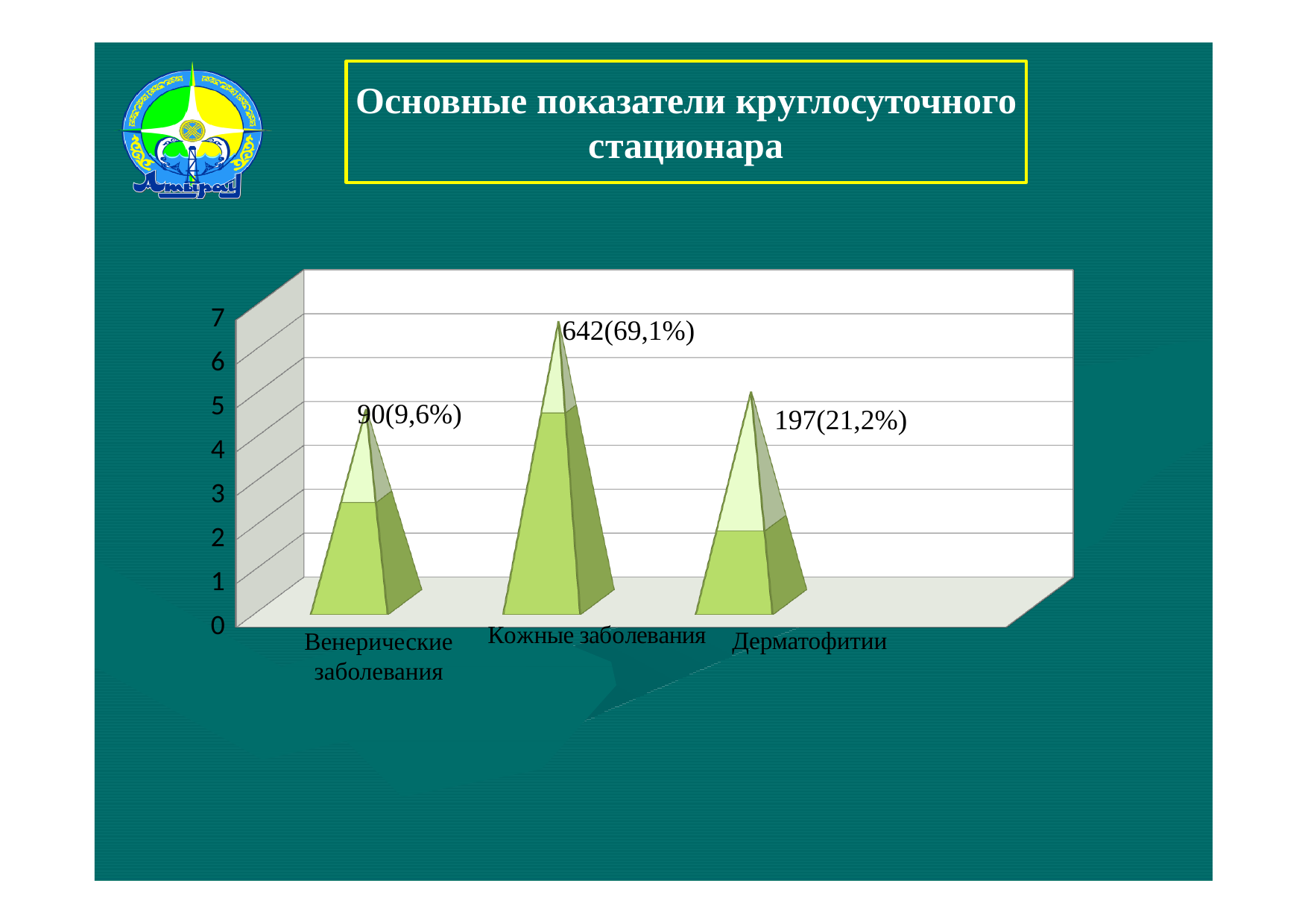
What is the title of the slide? Основные показатели круглосуточного стационара Which is larger, the value for Дерматофитии or the value for Венерические заболевания? Дерматофитии How many categories are shown in the chart? 3 Is the bar for Венерические заболевания greater or less than 6 on the axis? less What is the difference between the counts for Кожные заболевания and Дерматофитии? 445 Which category has the lowest value? Венерические заболевания What value is labelled for Кожные заболевания? 642(69,1%) What is the difference between the counts for Дерматофитии and Венерические заболевания? 107 Which category has the highest value? Кожные заболевания What value is labelled for Венерические заболевания? 90(9,6%) What value is labelled for Дерматофитии? 197(21,2%) Is the bar for Кожные заболевания greater or less than 6 on the axis? greater